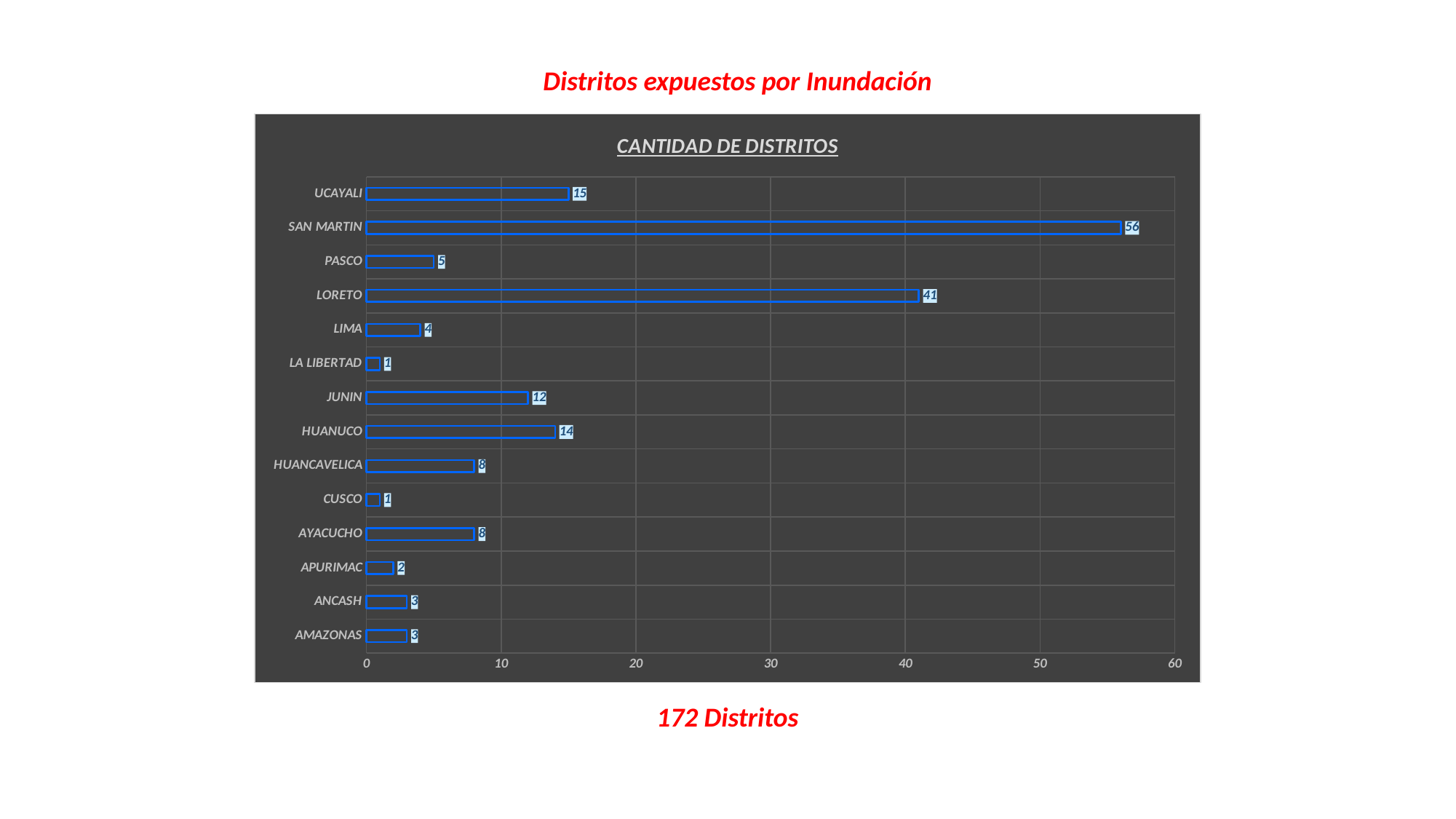
What kind of chart is shown on the slide? bar chart How many categories are shown in the chart? 14 What is the value for HUANUCO? 14 Is the value for LORETO greater or less than 40? greater What is the value for SAN MARTIN? 56 What is the value for APURIMAC? 2 What is the value for LORETO? 41 Which is larger, the value for HUANUCO or the value for UCAYALI? UCAYALI What is the difference between the values for UCAYALI and JUNIN? 3 What is the difference between the values for SAN MARTIN and LORETO? 15 What is the title of the chart? CANTIDAD DE DISTRITOS Which category has the highest value? SAN MARTIN